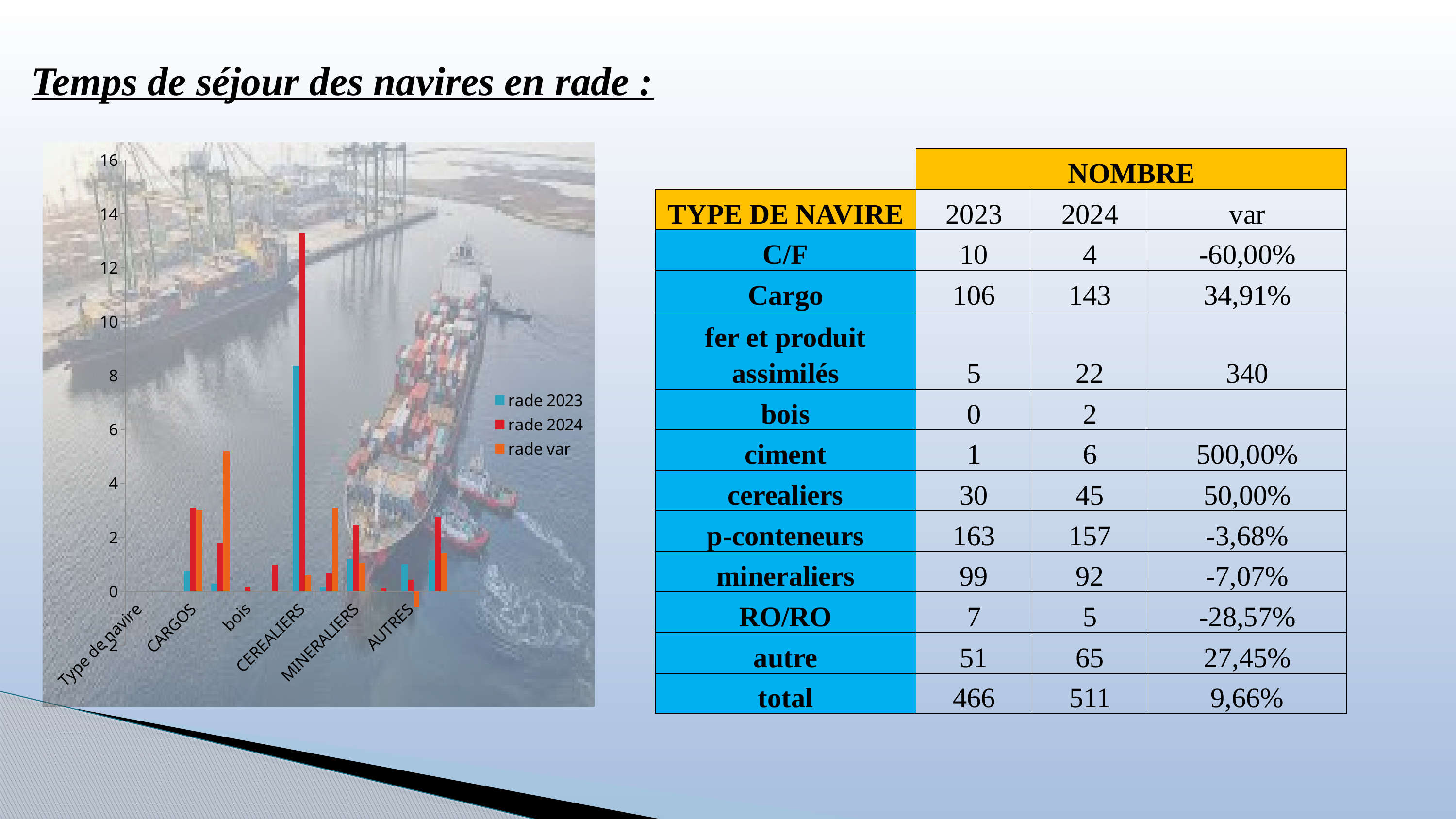
Is the rade 2023 value for CARGOS greater or less than 2? less For CARGOS, which is larger: the rade 2023 bar or the rade 2024 bar? rade 2024 Is the rade 2023 value for CEREALIERS greater or less than 6? greater How many series does the chart legend list? 3 Which colour represents the rade 2024 series in the chart? red For CEREALIERS, which is larger: the rade 2023 bar or the rade 2024 bar? rade 2024 Is the rade 2024 value for CEREALIERS greater or less than 12? greater For which category is the rade 2024 bar the tallest? CEREALIERS What kind of chart is shown on the left of the slide? bar chart What are the three series named in the chart legend? rade 2023, rade 2024, rade var